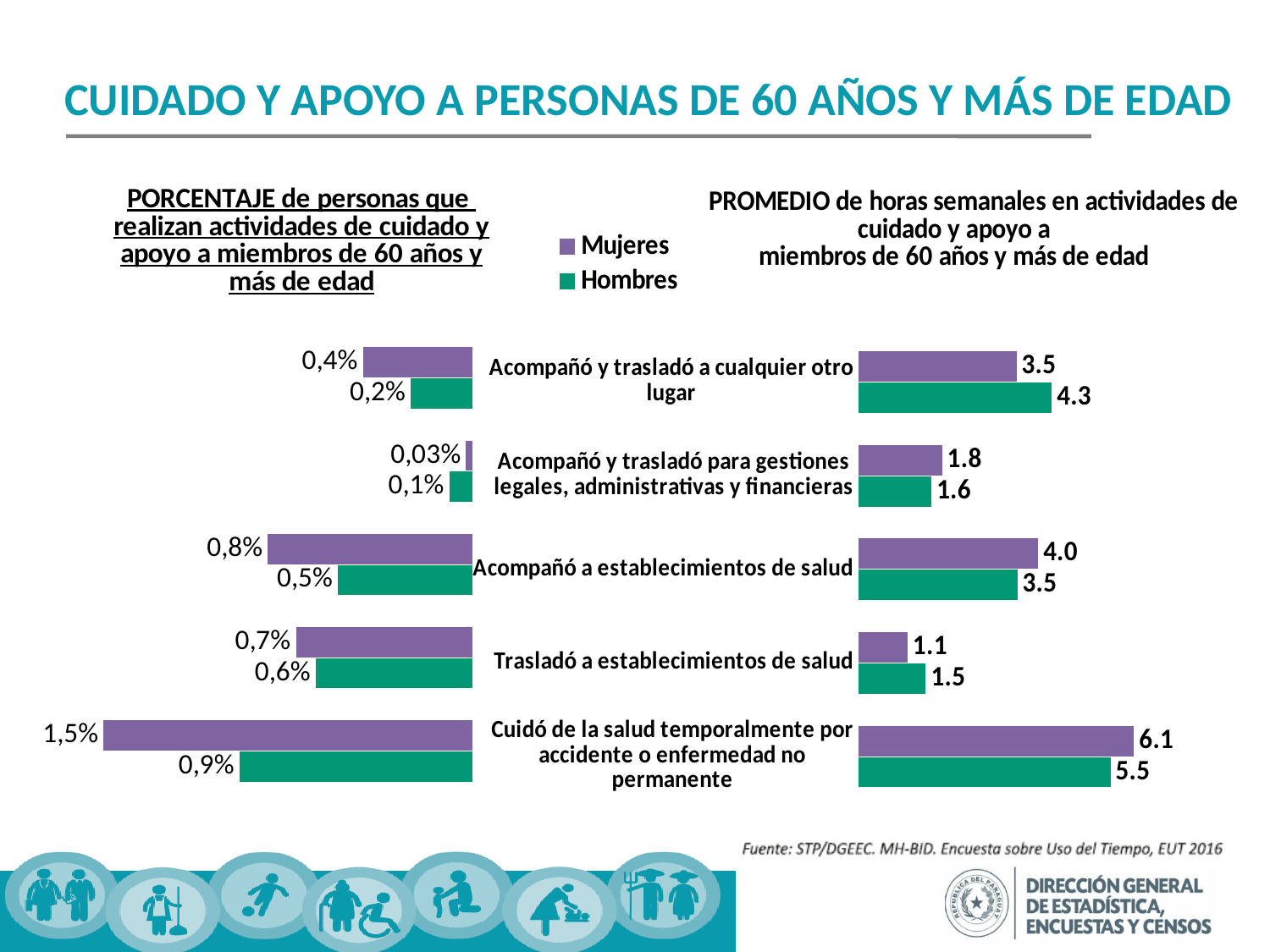
In the PROMEDIO de horas semanales chart on the right, which is larger for 'Trasladó a establecimientos de salud': Mujeres or Hombres? Hombres What kind of chart is the PROMEDIO de horas semanales chart on the right? Bar chart In the PORCENTAJE chart on the left, what is the value for Mujeres for 'Cuidó de la salud temporalmente por accidente o enfermedad no permanente'? 1,5% In the PORCENTAJE chart on the left, what is the difference between Mujeres and Hombres for 'Acompañó a establecimientos de salud'? 0,3% In the PORCENTAJE chart on the left, which category has the lowest value for Mujeres? Acompañó y trasladó para gestiones legales, administrativas y financieras How many categories are shown in the PORCENTAJE chart on the left? 5 How many series does the legend list? 2 In the PROMEDIO de horas semanales chart on the right, what is the value for Mujeres for 'Acompañó a establecimientos de salud'? 4.0 In the PROMEDIO de horas semanales chart on the right, what is the value for Hombres for 'Acompañó y trasladó a cualquier otro lugar'? 4.3 In the PORCENTAJE chart on the left, what is the value for Hombres for 'Acompañó y trasladó a cualquier otro lugar'? 0,2% In the PROMEDIO de horas semanales chart on the right, which category has the highest value for Mujeres? Cuidó de la salud temporalmente por accidente o enfermedad no permanente In the PROMEDIO de horas semanales chart on the right, what is the difference between Mujeres and Hombres for 'Cuidó de la salud temporalmente por accidente o enfermedad no permanente'? 0.6